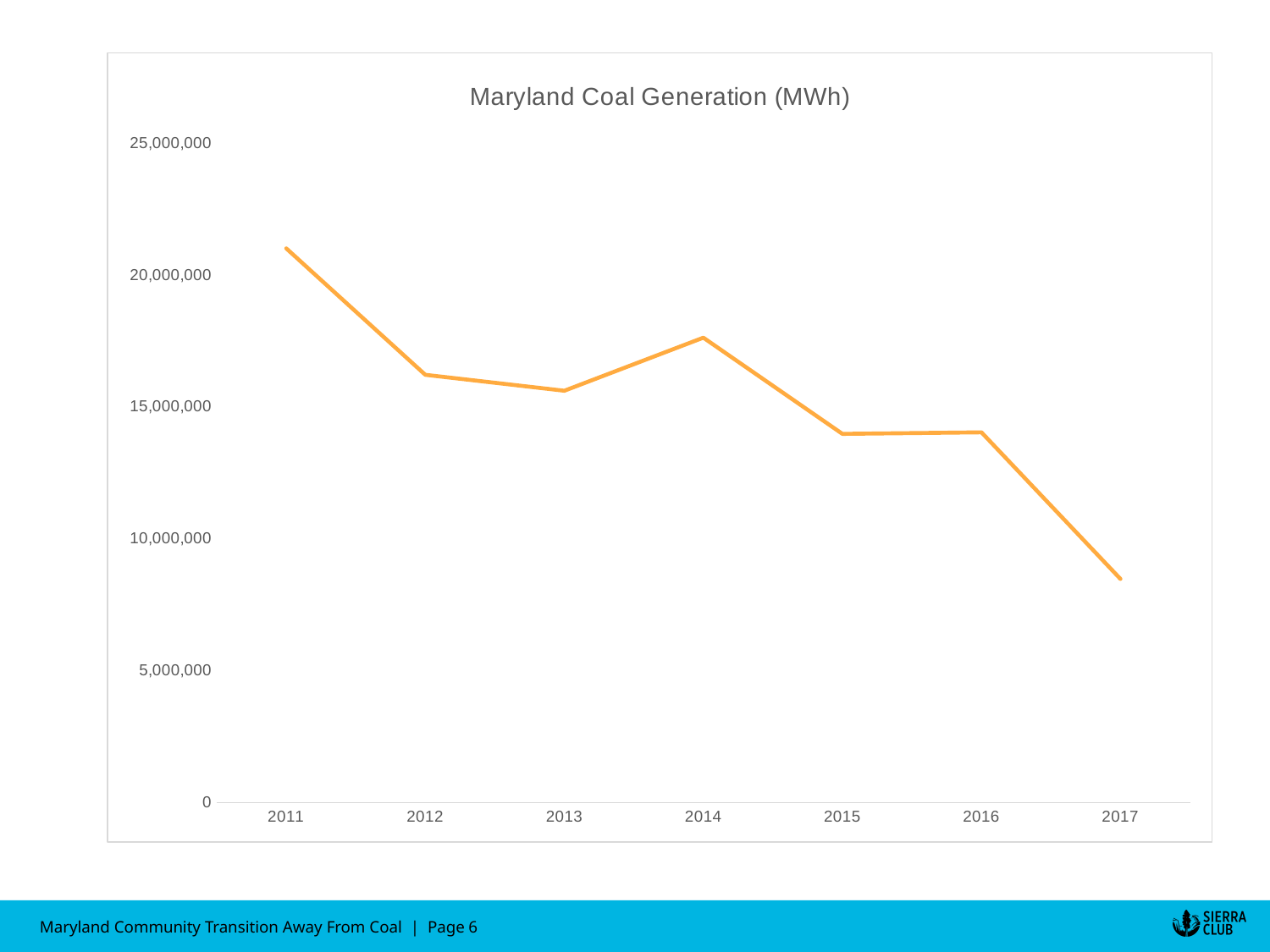
How many years are plotted on the x axis? 7 Overall, do the values rise or fall from 2011 to 2017? fall Is the value for 2015 greater or less than 15,000,000? less Which year has the larger value, 2016 or 2017? 2016 What kind of chart is shown on the slide? line chart Which year has the lowest coal generation? 2017 Is the value for 2017 greater or less than 10,000,000? less Which year has the larger value, 2014 or 2012? 2014 What is the title of the chart? Maryland Coal Generation (MWh) Which year has the highest coal generation? 2011 Is the value for 2014 greater or less than 15,000,000? greater